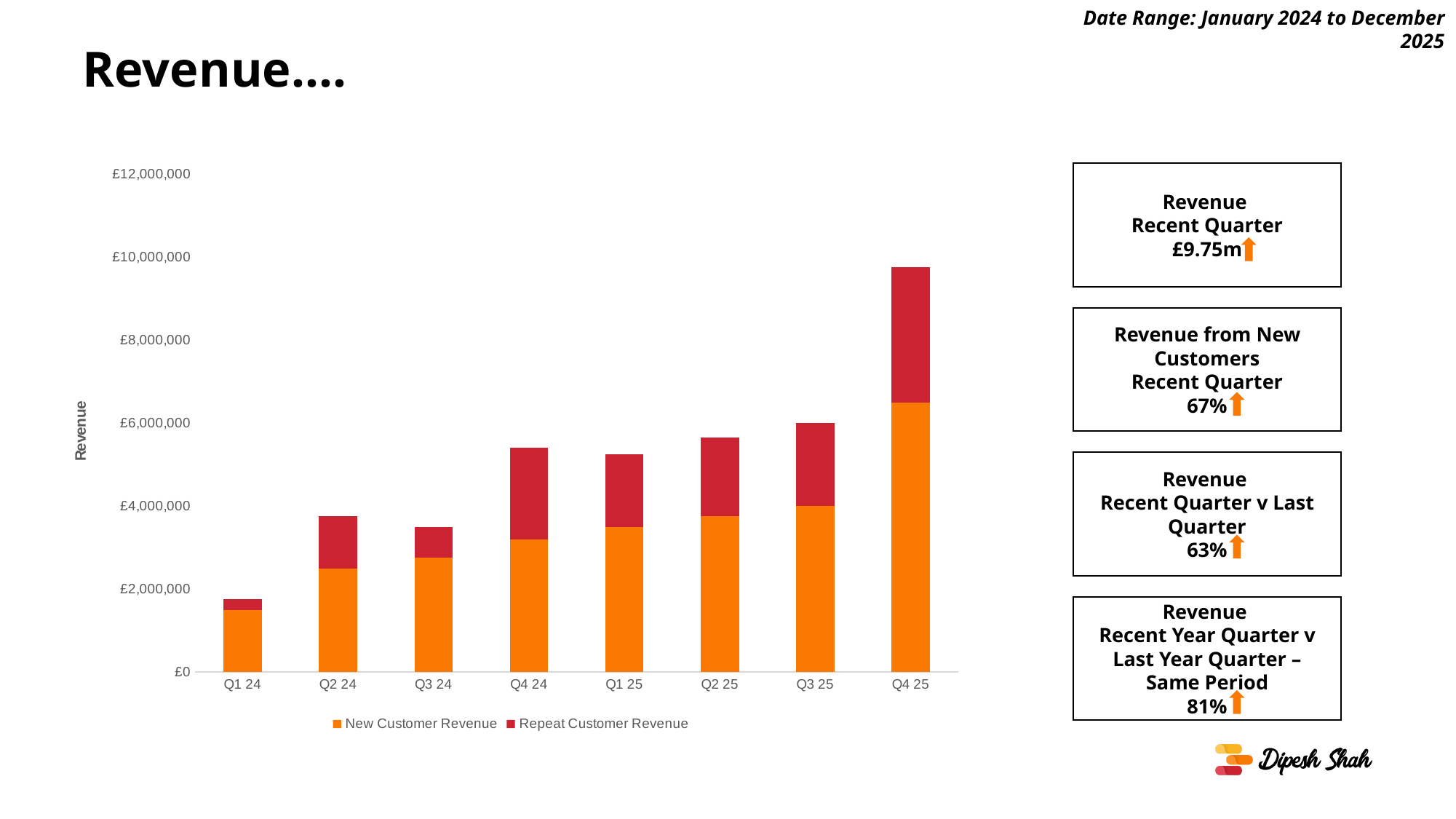
What kind of chart is shown on the slide? Stacked bar chart Which quarter has the larger Repeat Customer Revenue segment, Q3 24 or Q4 24? Q4 24 How many quarters are plotted on the x axis of the chart? 8 Which quarter has the larger total revenue bar, Q1 24 or Q2 24? Q2 24 Which series is shown in orange in the chart? New Customer Revenue Which quarter has the lowest total revenue bar? Q1 24 Is the total revenue bar for Q1 24 greater or less than £2,000,000? less How many series does the chart legend list? 2 Which quarter has the highest total revenue bar? Q4 25 Is the total revenue bar for Q2 25 greater or less than £6,000,000? less Do the total revenue bars generally rise or fall from Q1 24 to Q4 25? rise Is the total revenue bar for Q4 25 greater or less than £8,000,000? greater